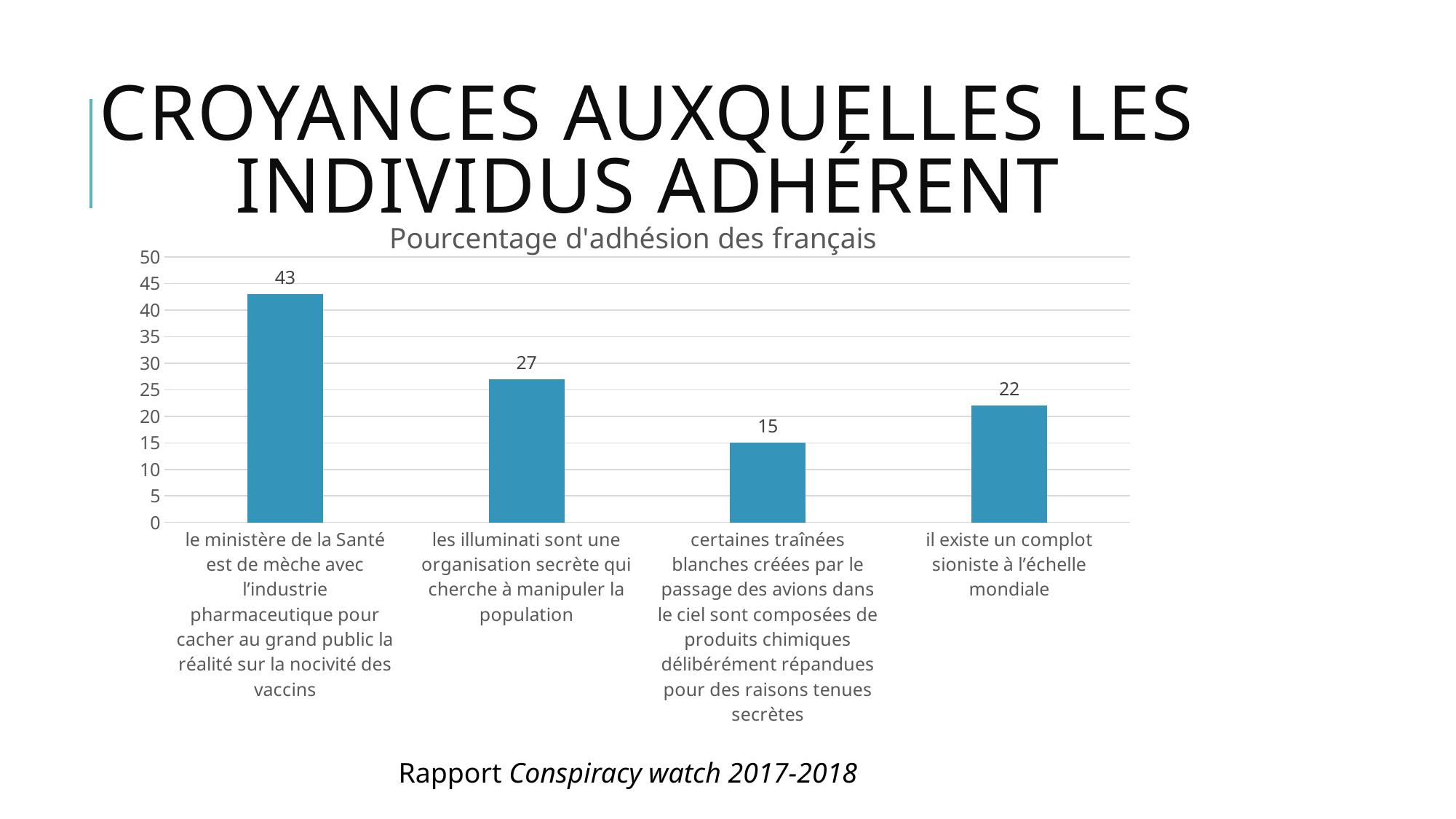
What kind of chart is shown on the slide? bar chart Which belief has the highest percentage of adherence? le ministère de la Santé est de mèche avec l'industrie pharmaceutique pour cacher au grand public la réalité sur la nocivité des vaccins Which belief has the lowest percentage of adherence? certaines traînées blanches créées par le passage des avions dans le ciel sont composées de produits chimiques délibérément répandues pour des raisons tenues secrètes What is the value for the belief that the Ministry of Health is in league with the pharmaceutical industry about vaccines? 43 What is the difference between the value for the Zionist plot belief and the value for the chemtrails (traînées blanches) belief? 7 How many beliefs (categories) are shown in the chart? 4 What is the title of the chart? Pourcentage d'adhésion des français What is the value for the belief that there is a Zionist plot on a global scale (complot sioniste à l'échelle mondiale)? 22 What is the value for the belief that the illuminati are a secret organisation seeking to manipulate the population? 27 What is the difference between the value for the vaccine/pharmaceutical belief and the value for the illuminati belief? 16 Which is larger: the value for the illuminati belief or the value for the Zionist plot belief? les illuminati sont une organisation secrète qui cherche à manipuler la population Is the value for the chemtrails (traînées blanches) belief greater or less than 20? less